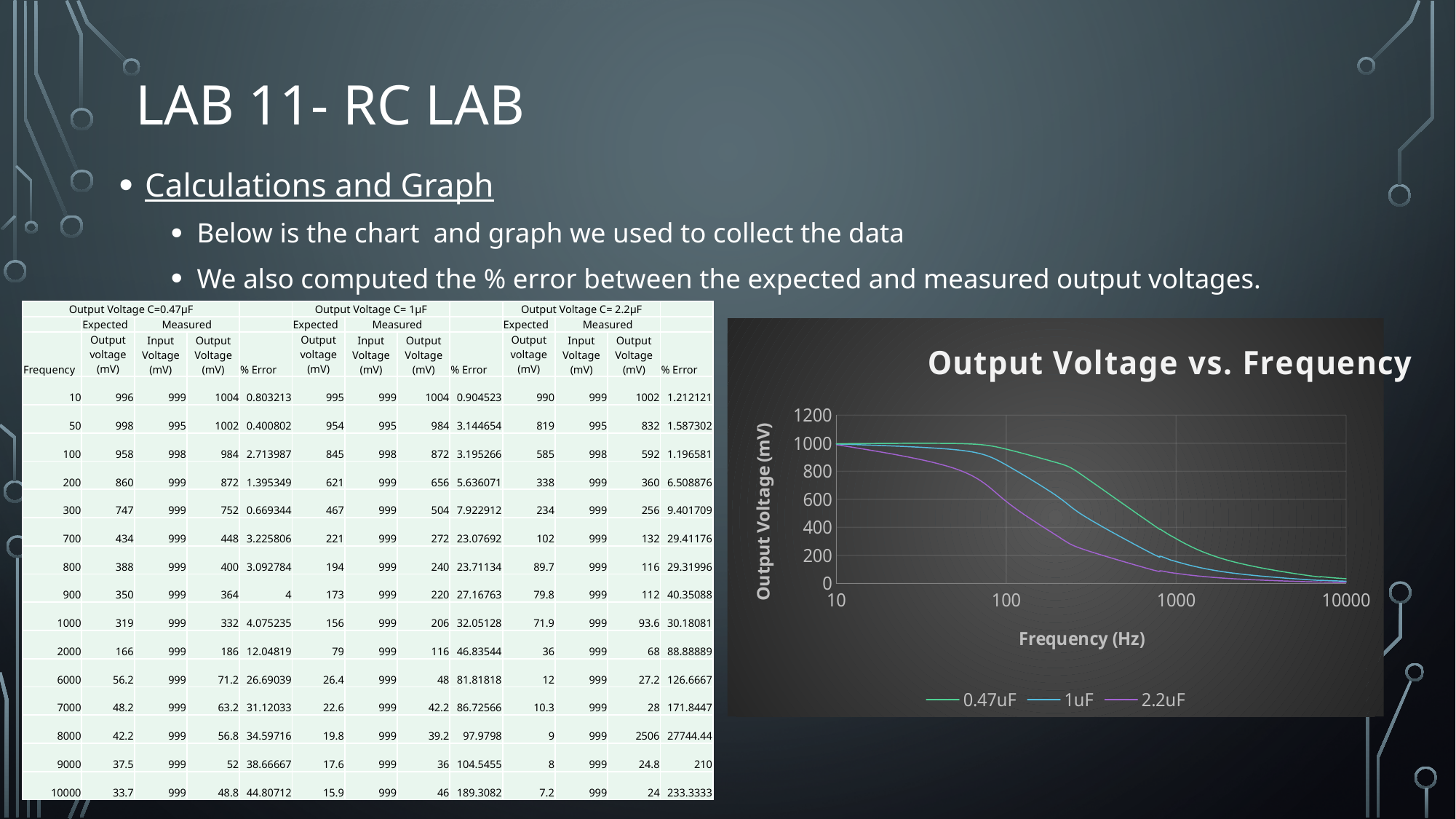
At 1000 Hz, is the output voltage for the 2.2uF series greater or less than 200? less What are the series names listed in the chart's legend? 0.47uF, 1uF, 2.2uF What kind of chart is shown on the slide? line chart At 100 Hz, is the output voltage for the 0.47uF series greater or less than 800? greater At 100 Hz, which series has the highest output voltage? 0.47uF At 100 Hz, which series has the lowest output voltage? 2.2uF At 100 Hz, is the output voltage for the 2.2uF series greater or less than 800? less How many series does the chart's legend list? 3 Do the output voltage values rise or fall as frequency increases along the x axis? fall What is the title of the chart? Output Voltage vs. Frequency At 1000 Hz, which series has a higher output voltage, 1uF or 2.2uF? 1uF